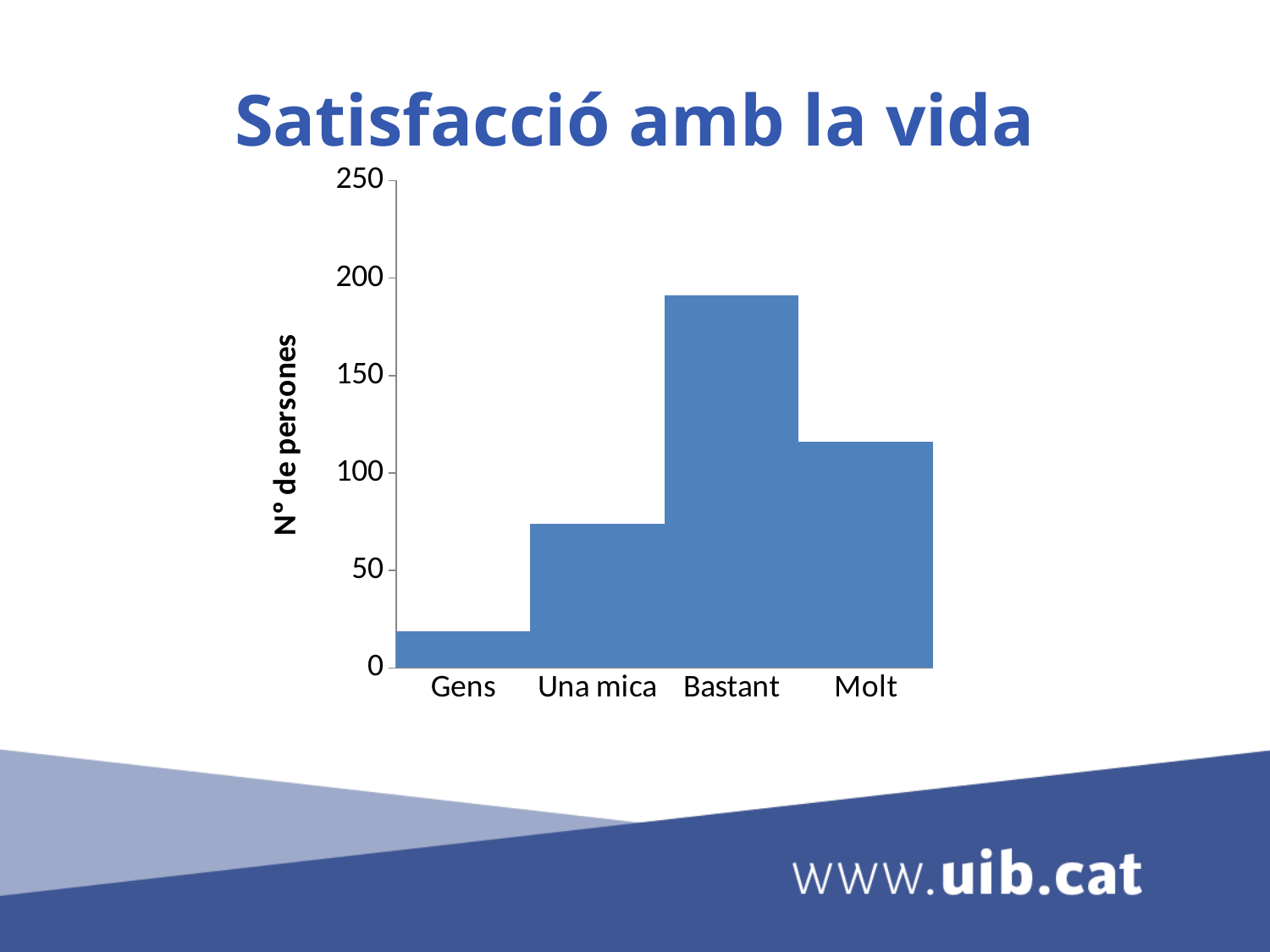
Which category has the highest number of people? Bastant Which is larger, the value for Molt or the value for Una mica? Molt How many categories are shown on the x axis? 4 Is the value for Gens greater or less than 50? less Is the value for Una mica greater or less than 100? less What kind of chart is shown on the slide? bar chart Which category has the lowest number of people? Gens What is the label of the vertical axis? N° de persones Which is larger, the value for Gens or the value for Una mica? Una mica Is the value for Bastant greater or less than 150? greater What is the title of the chart? Satisfacció amb la vida